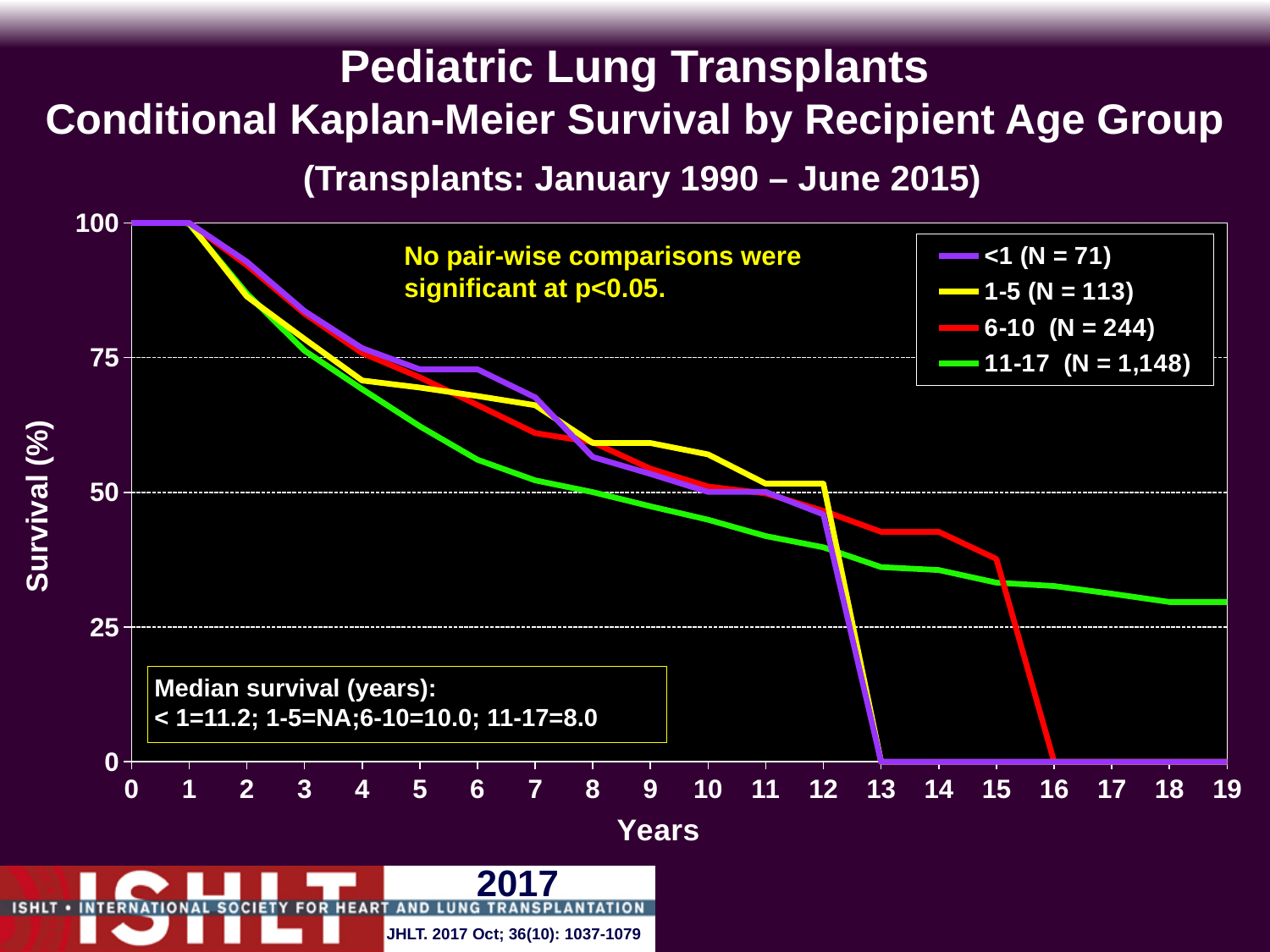
What is the number of patients (N) in the 11-17 age group? 1,148 What is the difference in median survival (years) between the <1 group and the 6-10 group? 1.2 Which age group has the largest number of patients (N)? 11-17 What is the median survival in years for the <1 age group? 11.2 What is the median survival in years for the 11-17 age group? 8.0 Do the survival curves rise or fall as years increase? fall What is the number of patients (N) in the 6-10 age group? 244 Which age group has the smallest number of patients (N)? <1 How many recipient age groups does the legend list? 4 What kind of chart is shown on the slide? line chart Which age group's curve is lowest at 5 years? 11-17 Is the survival value for the 11-17 group at 19 years greater or less than 50? less